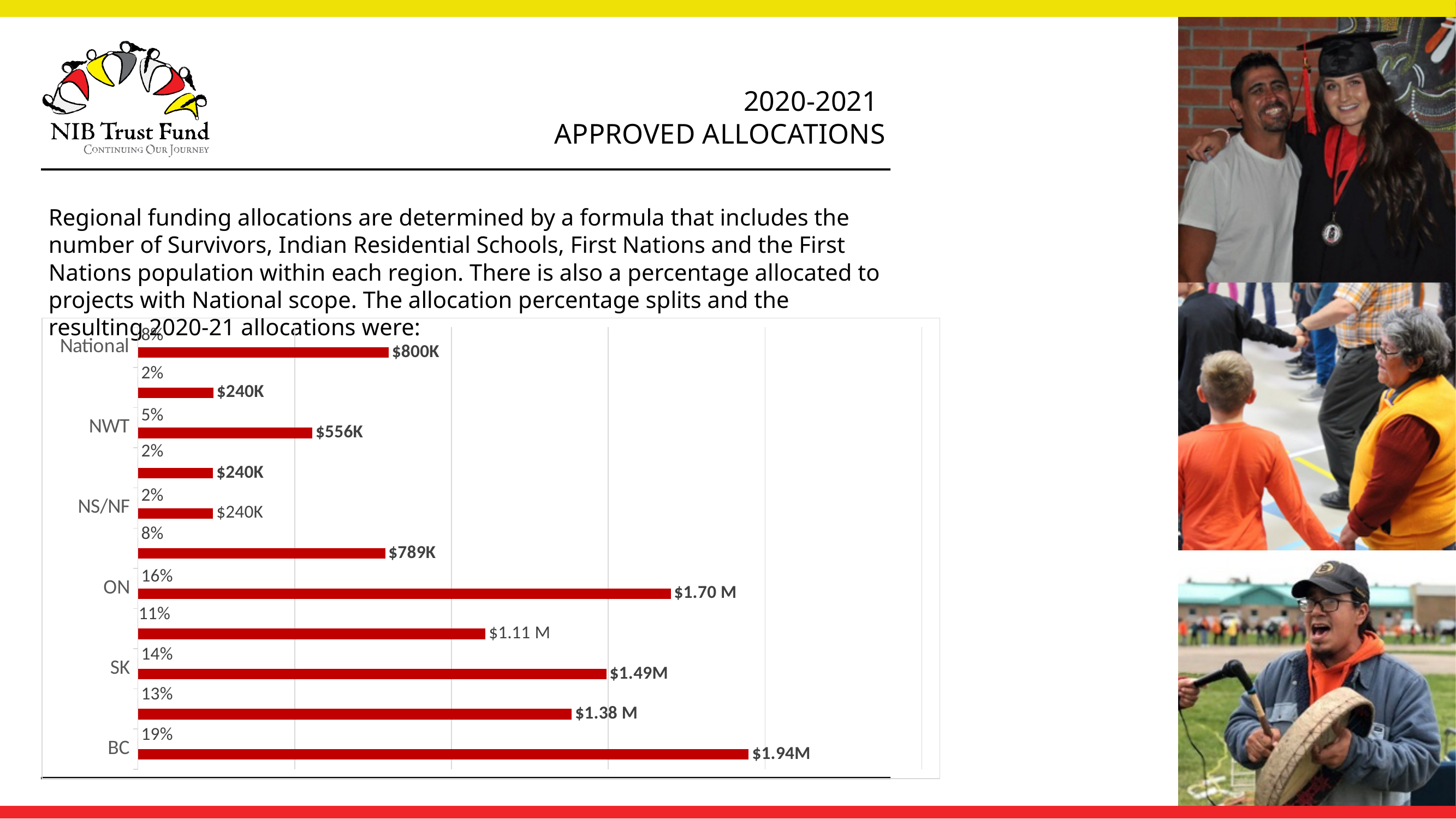
What is the approved allocation for ON? $1.70 M What percentage split is shown for ON? 16% What is the approved allocation for BC? $1.94M Which has the larger allocation, ON or SK? ON How many bars are plotted in the chart? 11 What is the approved allocation for NS/NF? $240K Which region has the highest approved allocation? BC What kind of chart is shown on the slide? Bar chart What is the approved allocation for National? $800K What percentage split is shown for BC? 19% What is the approved allocation for NWT? $556K What is the approved allocation for SK? $1.49M